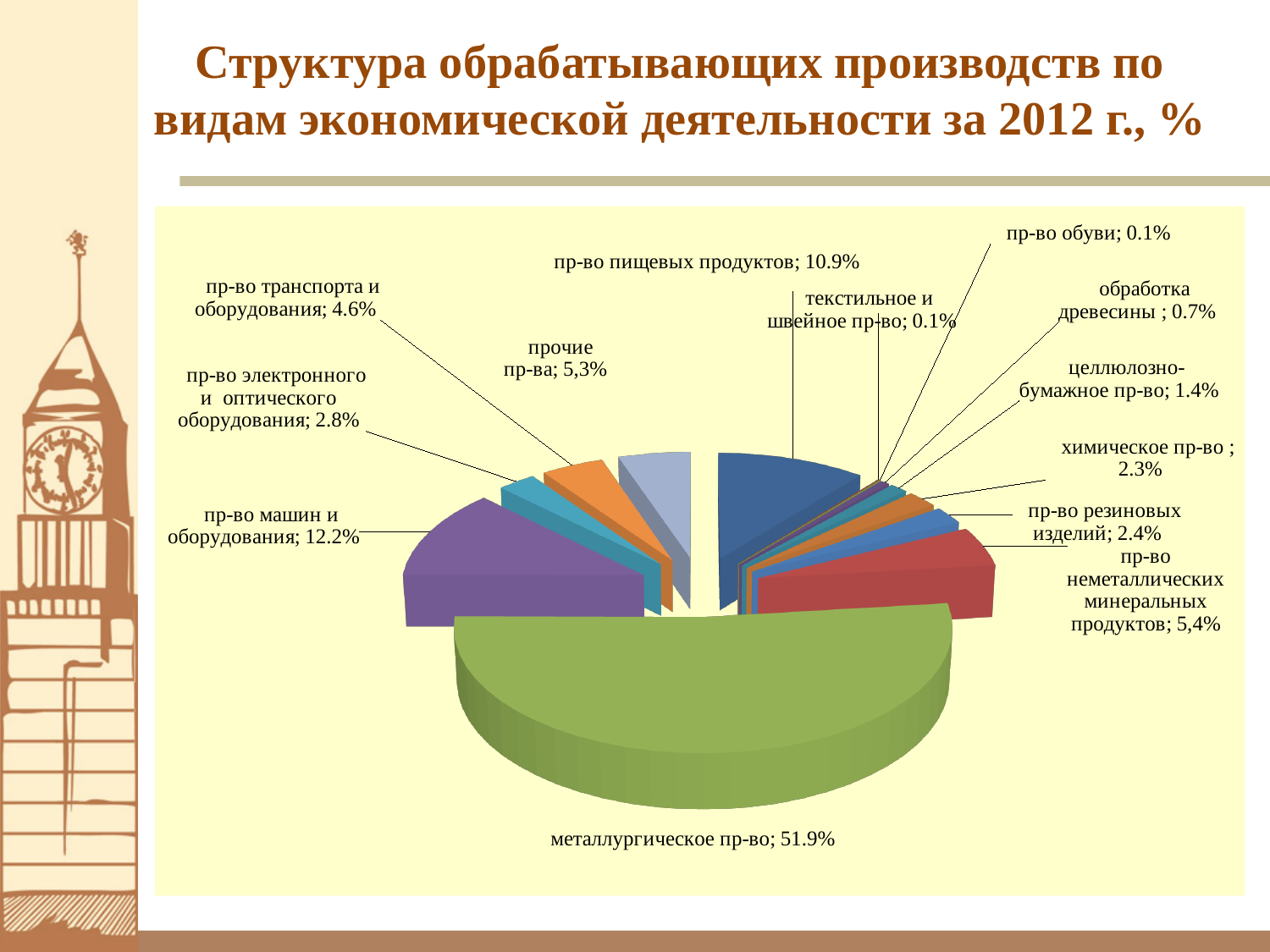
What is the difference in percentage points between металлургическое пр-во (51.9%) and пр-во машин и оборудования (12.2%)? 39.7 What share does металлургическое пр-во have in the pie chart? 51.9% What year does the chart title say the data refers to? 2012 What type of chart is shown on the slide? pie chart What is the value for пр-во пищевых продуктов? 10.9% What is the value for прочие пр-ва? 5,3% How many categories (slices) are labelled in the pie chart? 13 What is the difference in percentage points between пр-во электронного и оптического оборудования (2.8%) and пр-во резиновых изделий (2.4%)? 0.4 Which category has the largest share of the pie? металлургическое пр-во What is the value for пр-во машин и оборудования? 12.2% Which is larger: пр-во машин и оборудования or пр-во пищевых продуктов? пр-во машин и оборудования What is the value for целлюлозно-бумажное пр-во? 1.4%